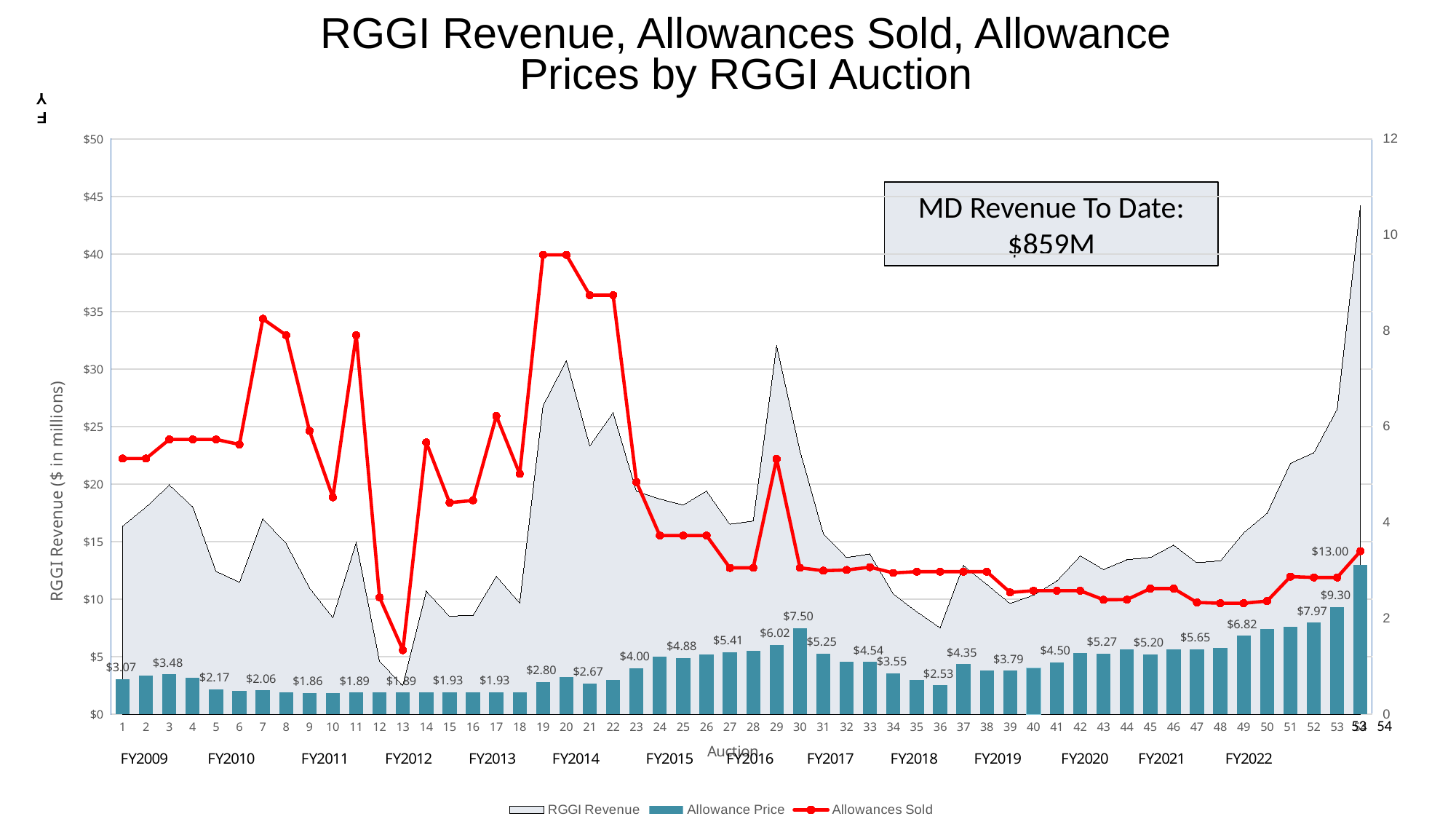
What MD Revenue To Date figure is shown in the box on the chart? $859M Which auction has the highest Allowance Price? 54 Is the Allowances Sold value at auction 19 greater or less than 8? greater Is the RGGI Revenue at auction 29 greater or less than $30? greater What is the difference between the Allowance Price at auction 30 and at auction 29? $1.48 How many series does the legend list? 3 What is the Allowance Price at auction 54? $13.00 What is the difference between the Allowance Price at auction 54 and at auction 53? $3.70 Which is larger, the Allowance Price at auction 30 or at auction 36? auction 30 Does the Allowance Price rise or fall from auction 39 to auction 54? rise What is the Allowance Price at auction 30? $7.50 What is the Allowance Price at auction 1? $3.07